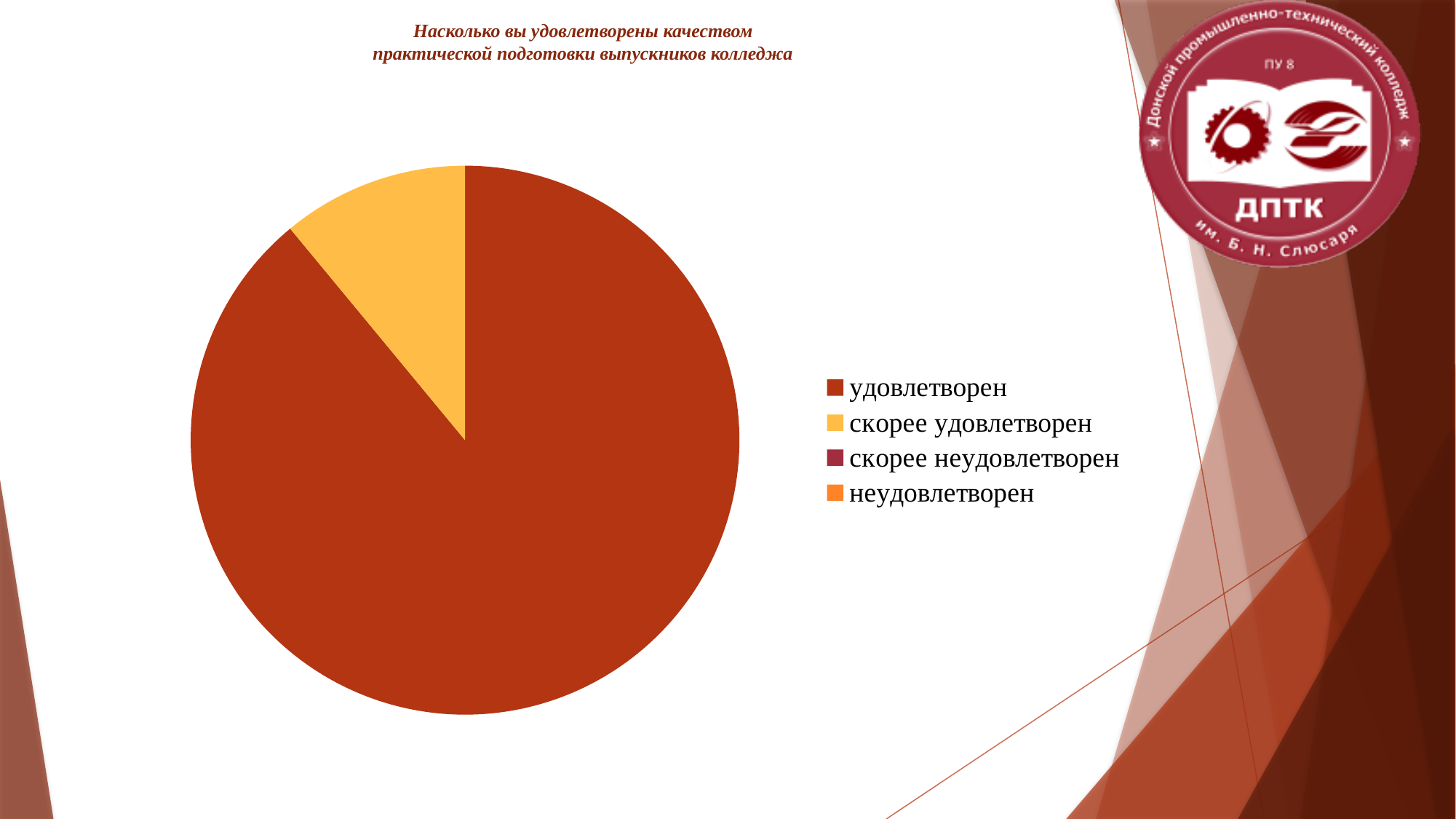
Which category has the largest slice of the pie chart? удовлетворен What colour is the slice for скорее удовлетворен in the pie chart? yellow How many slices are visibly drawn in the pie chart? 2 Which is larger in the pie chart: the slice for удовлетворен or the slice for скорее удовлетворен? удовлетворен How many entries does the legend of the pie chart list? 4 What is the title of the chart on the slide? Насколько вы удовлетворены качеством практической подготовки выпускников колледжа What kind of chart is shown on the slide? pie chart Does the slice for удовлетворен take up more or less than half of the pie chart? more